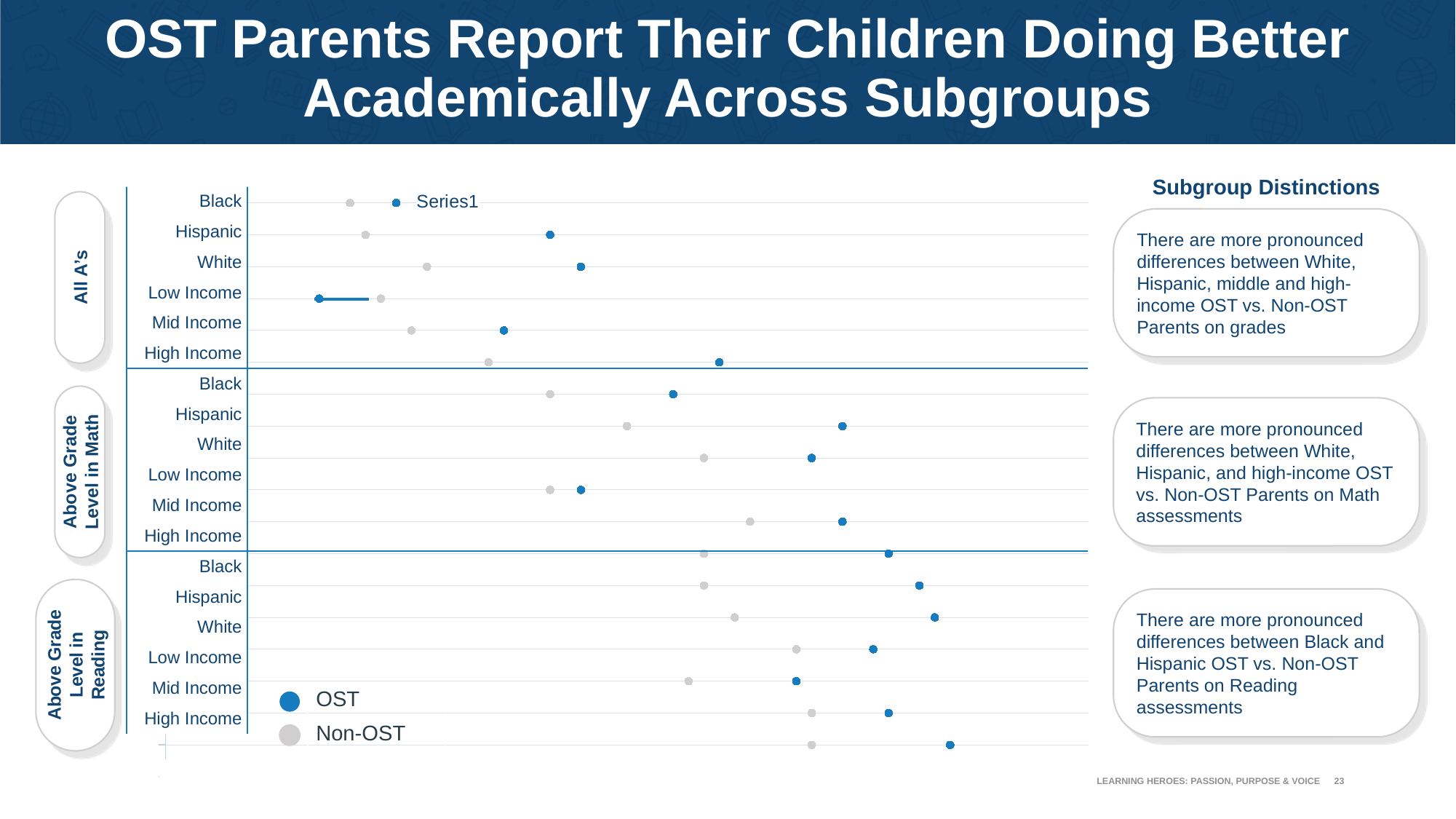
What kind of chart is shown on the slide? Dot plot In the 'All A's' section, which subgroup has the lowest OST value? Low Income In the 'Above Grade Level in Math' section, which subgroup has the lowest OST value? Low Income How many subgroup categories are plotted within the 'All A's' section? 6 In the 'All A's' section, which subgroup has the highest OST value? High Income What are the two series named in the chart legend? OST and Non-OST How many series does the legend at the bottom of the chart list? 2 How many category rows are plotted in the chart in total? 18 In the 'Above Grade Level in Math' section for Hispanic, which is larger: the OST value or the Non-OST value? OST In the 'All A's' section for Low Income, which is larger: the OST value or the Non-OST value? Non-OST In the 'Above Grade Level in Reading' section, which subgroup has the lowest Non-OST value? Low Income In the 'Above Grade Level in Reading' section, which subgroup has the highest OST value? High Income